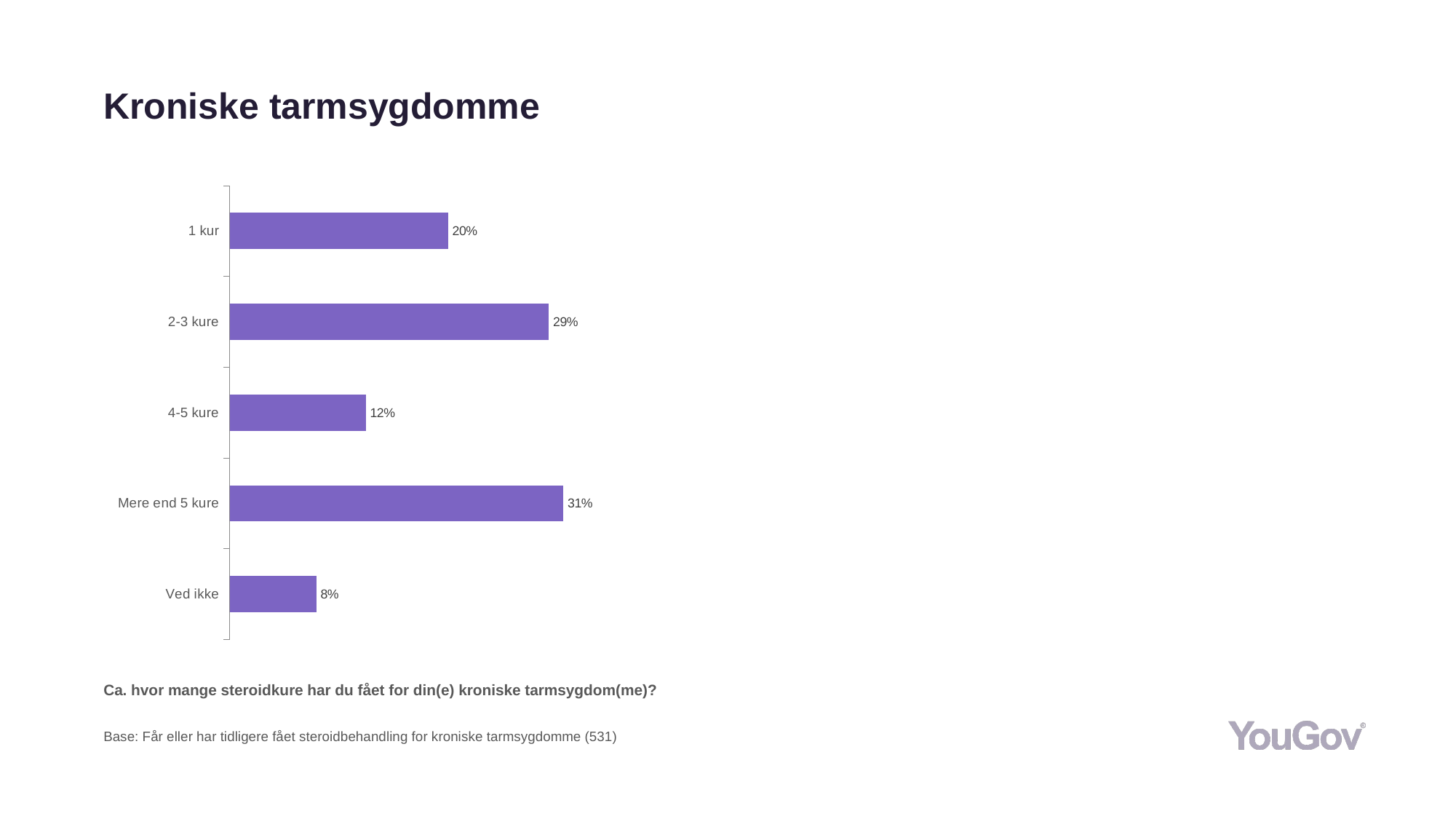
What is the title of the slide? Kroniske tarmsygdomme What is the value for "Mere end 5 kure"? 31% Which is larger, the value for "1 kur" or the value for "4-5 kure"? 1 kur What is the value for "4-5 kure"? 12% What is the difference between the values for "2-3 kure" and "1 kur"? 9% What is the value for "Ved ikke"? 8% Which category has the highest value? Mere end 5 kure Which category has the lowest value? Ved ikke How many categories are shown in the chart? 5 What is the value for "1 kur"? 20% What kind of chart is shown on the slide? Bar chart What is the value for "2-3 kure"? 29%